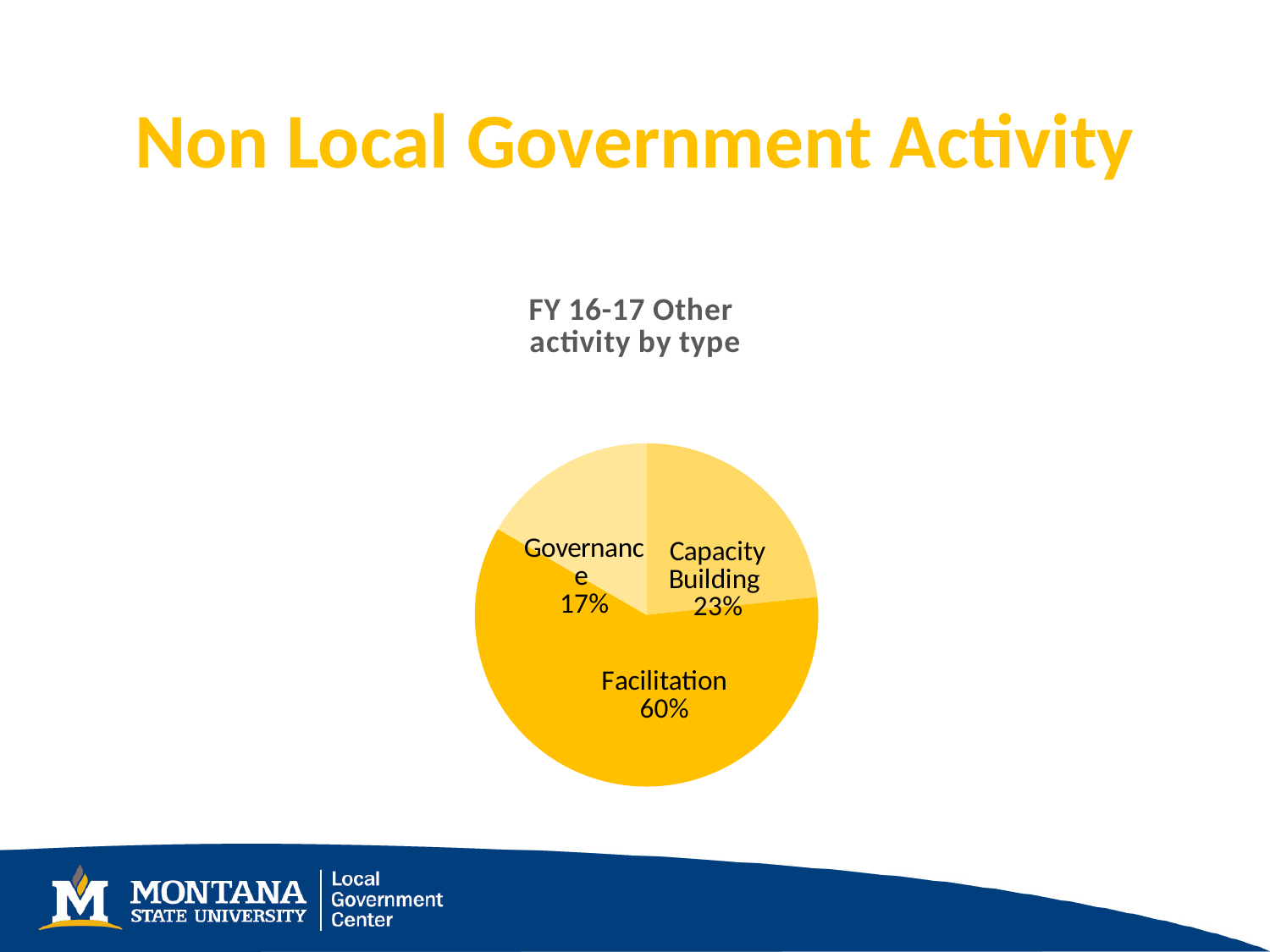
What is the title of the chart? FY 16-17 Other activity by type Which category has the largest slice of the pie? Facilitation What kind of chart is shown on the slide? Pie chart How many categories are shown in the pie chart? 3 What share of the pie does Capacity Building represent? 23% What share of the pie does Governance represent? 17% Which category has the smallest slice of the pie? Governance What share of the pie does Facilitation represent? 60% Is the share for Facilitation greater or less than 50%? greater Which is larger, the share for Capacity Building or the share for Governance? Capacity Building What is the difference in percentage points between Facilitation and Capacity Building? 37 What is the difference in percentage points between Capacity Building and Governance? 6